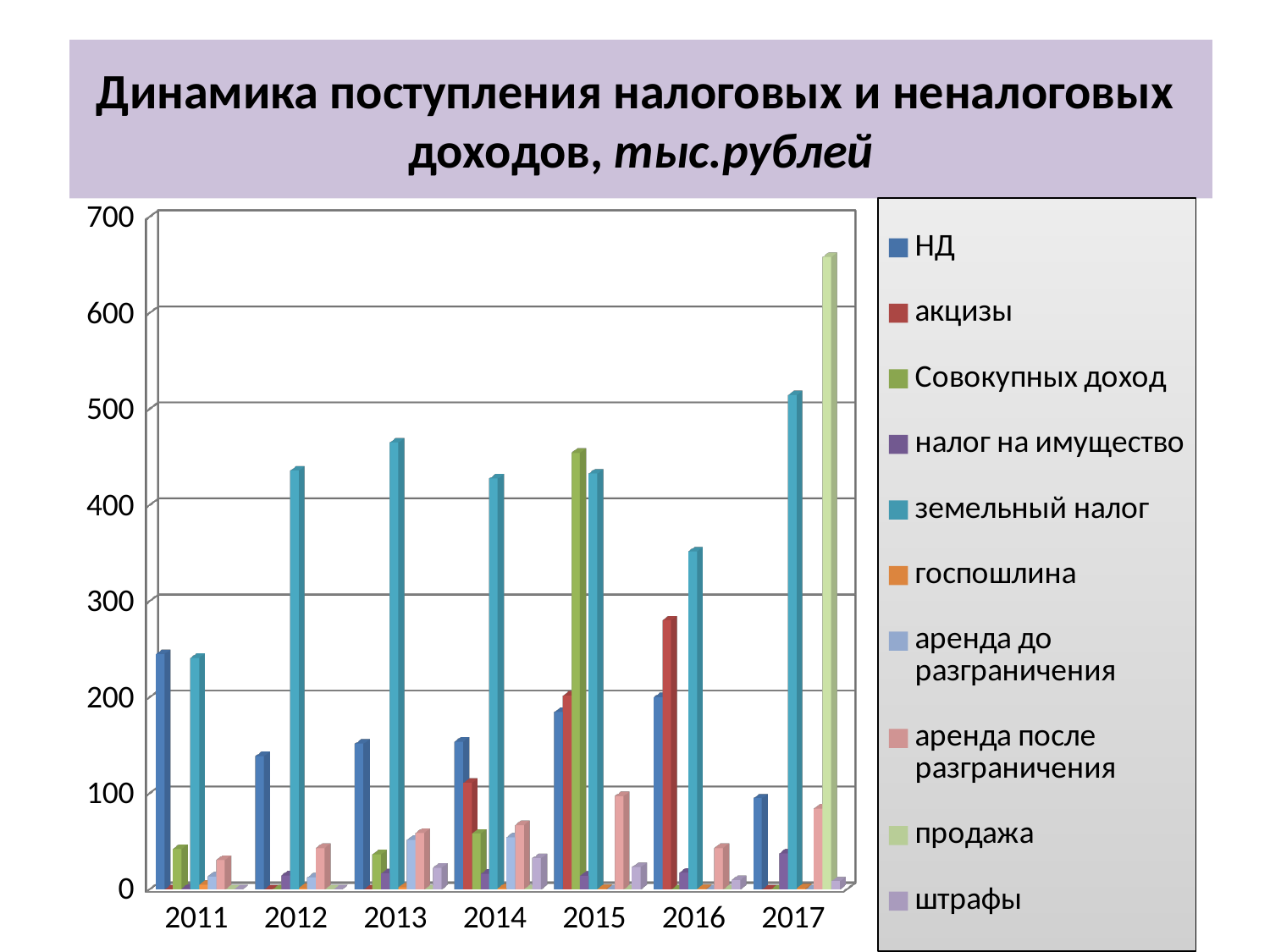
Is the value for продажа in 2017 greater or less than 600? greater Do the values for акцизы rise or fall from 2014 to 2016? rise Is the value for земельный налог in 2016 greater or less than 400? less What is the title of the chart on the slide? Динамика поступления налоговых и неналоговых доходов, тыс.рублей How many series does the legend list? 10 In which year is the value for земельный налог the highest? 2017 In 2016, which is larger: акцизы or НД? акцизы What kind of chart is shown on the slide? bar chart Is the value for Совокупных доход in 2015 greater or less than 400? greater How many years are shown along the x axis of the chart? 7 In which year is the value for НД the lowest? 2017